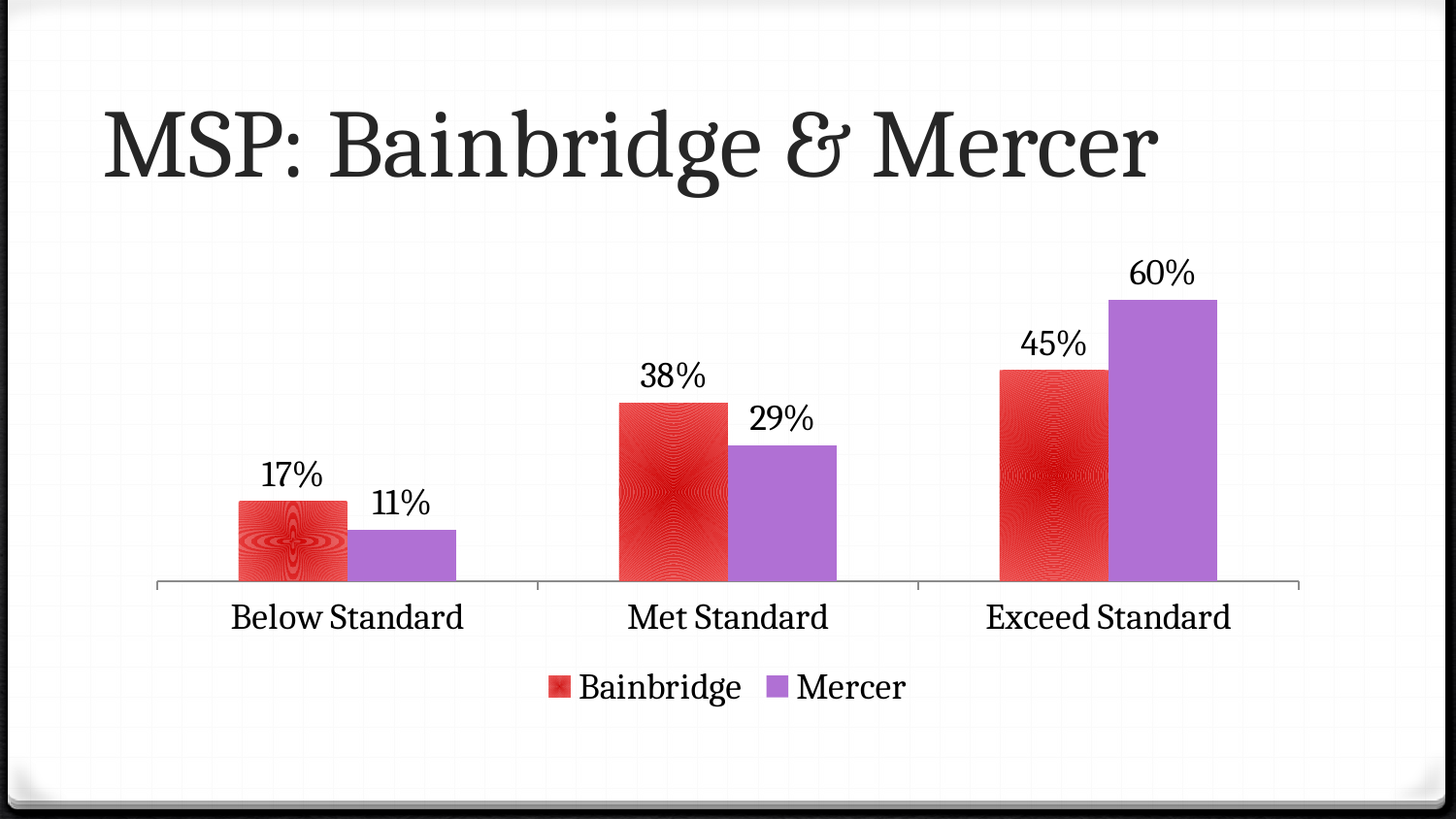
What is the value for Mercer in the Exceed Standard category? 60% How many series does the legend list? 2 Which is larger in the Below Standard category, Bainbridge or Mercer? Bainbridge What is the value for Mercer in the Met Standard category? 29% Do the Mercer values rise or fall from Below Standard to Exceed Standard? Rise How many categories are shown on the x axis? 3 Which category has the lowest value for Bainbridge? Below Standard What is the value for Bainbridge in the Below Standard category? 17% What is the difference between Bainbridge and Mercer in the Met Standard category? 9% What kind of chart is shown on the slide? Bar chart Which category has the highest value for Mercer? Exceed Standard What is the difference between Mercer and Bainbridge in the Exceed Standard category? 15%